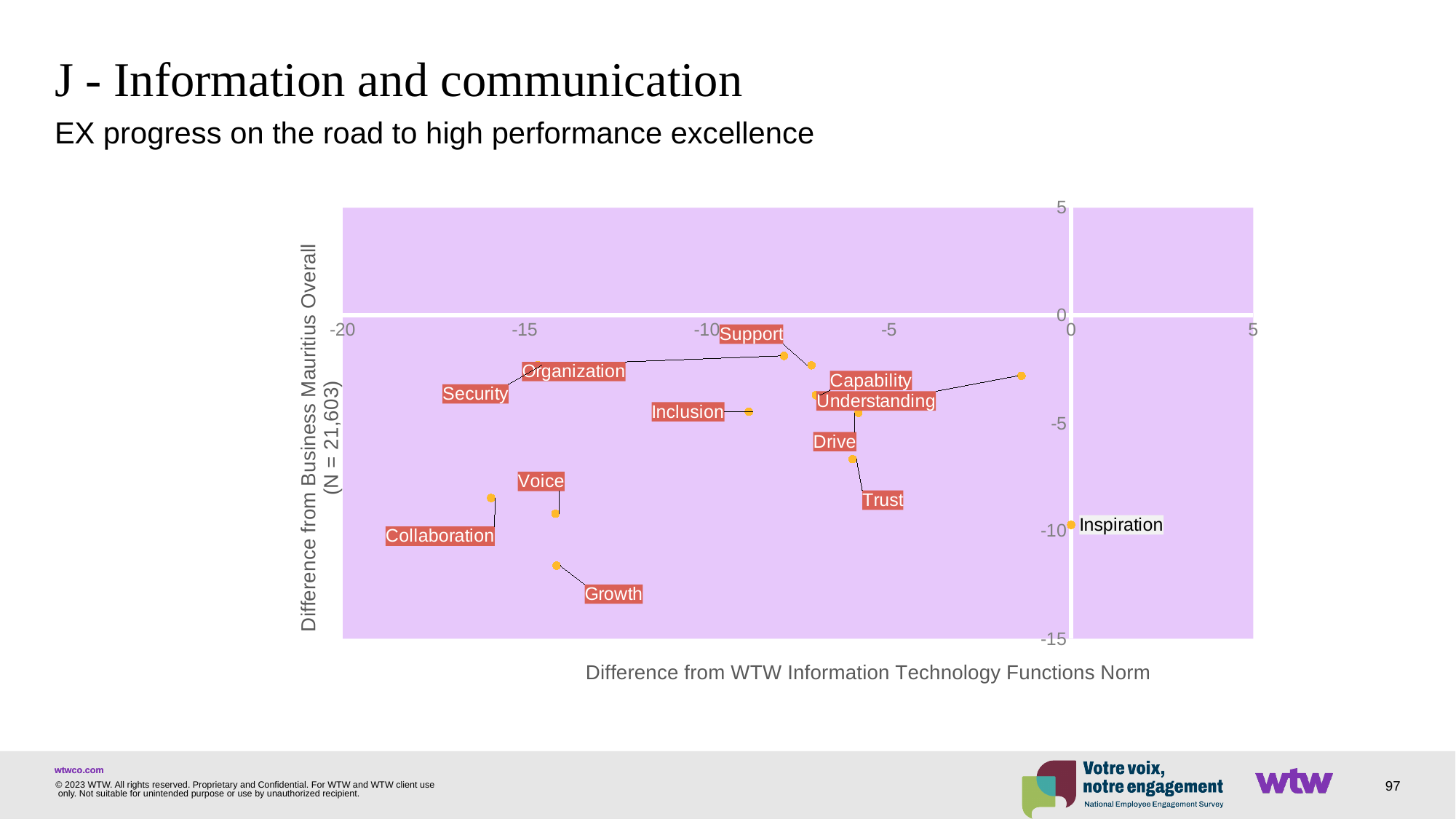
What is the title of the y axis? Difference from Business Mauritius Overall (N = 21,603) Which has the higher x-axis value, Inspiration or Collaboration? Inspiration What is the title of the x axis? Difference from WTW Information Technology Functions Norm Is the x-axis value for Collaboration greater or less than -15? less How many labeled data points are plotted on the chart? 12 Which point has the lowest value on the y axis? Growth Which has the higher y-axis value, Growth or Voice? Voice Is the x-axis value for Inclusion greater or less than -5? less Is the y-axis value for Voice greater or less than -5? less Which point has the highest value on the x axis? Inspiration What kind of chart is shown on the slide? scatter chart